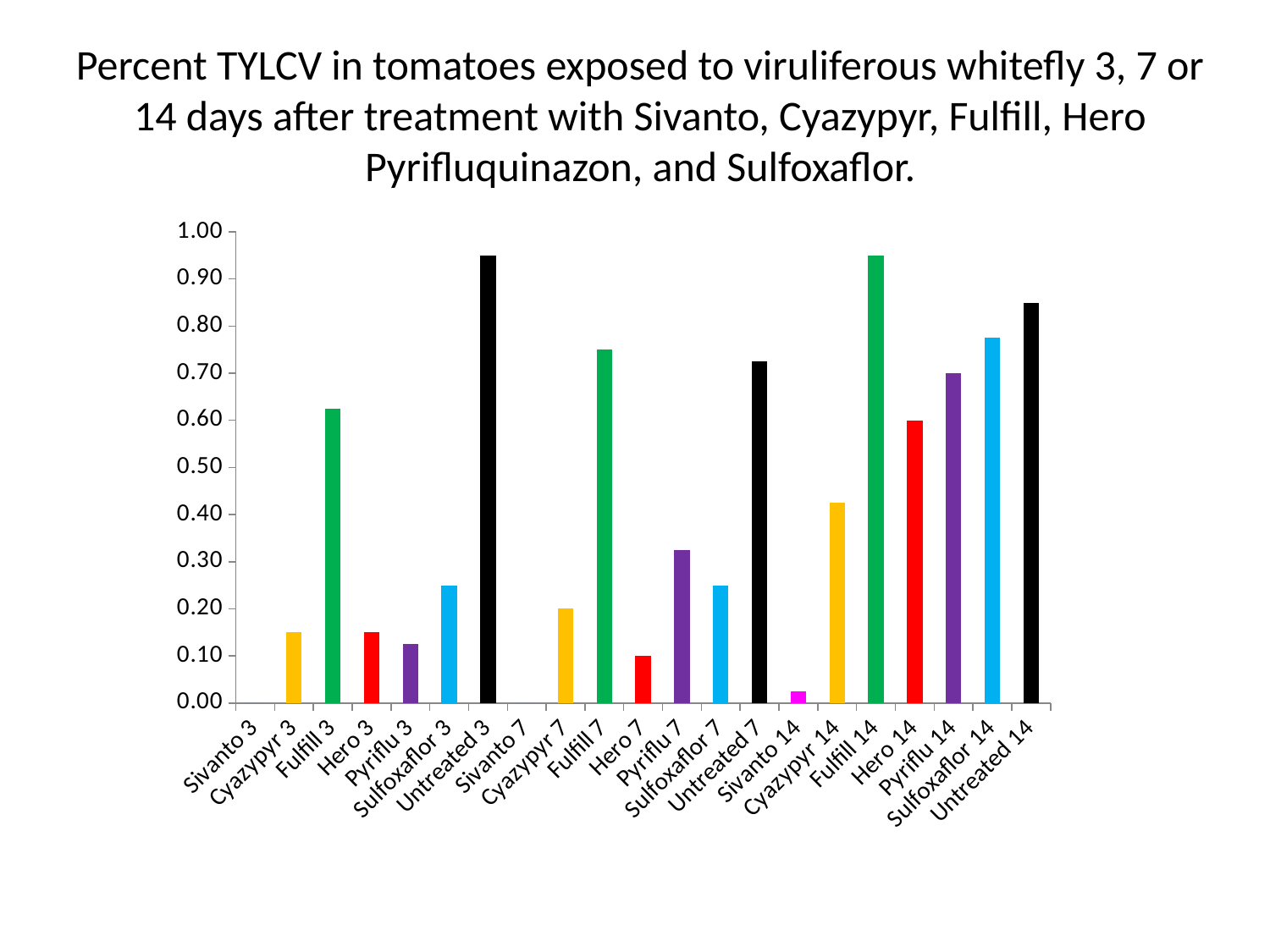
What kind of chart is shown on the slide? bar chart What is the value for Pyriflu 14? 0.70 Is the value for Sulfoxaflor 14 greater or less than 0.70? greater What is the difference between the values for Hero 14 and Hero 7? 0.50 What is the value for Cyazypyr 7? 0.20 How many categories are shown along the x axis? 21 Is the value for Sivanto 14 greater or less than 0.10? less Is the value for Untreated 3 greater or less than 0.90? greater Which is larger, the value for Fulfill 14 or the value for Hero 14? Fulfill 14 Which is larger, the value for Cyazypyr 3 or the value for Cyazypyr 14? Cyazypyr 14 What is the value for Hero 14? 0.60 What is the value for Hero 7? 0.10